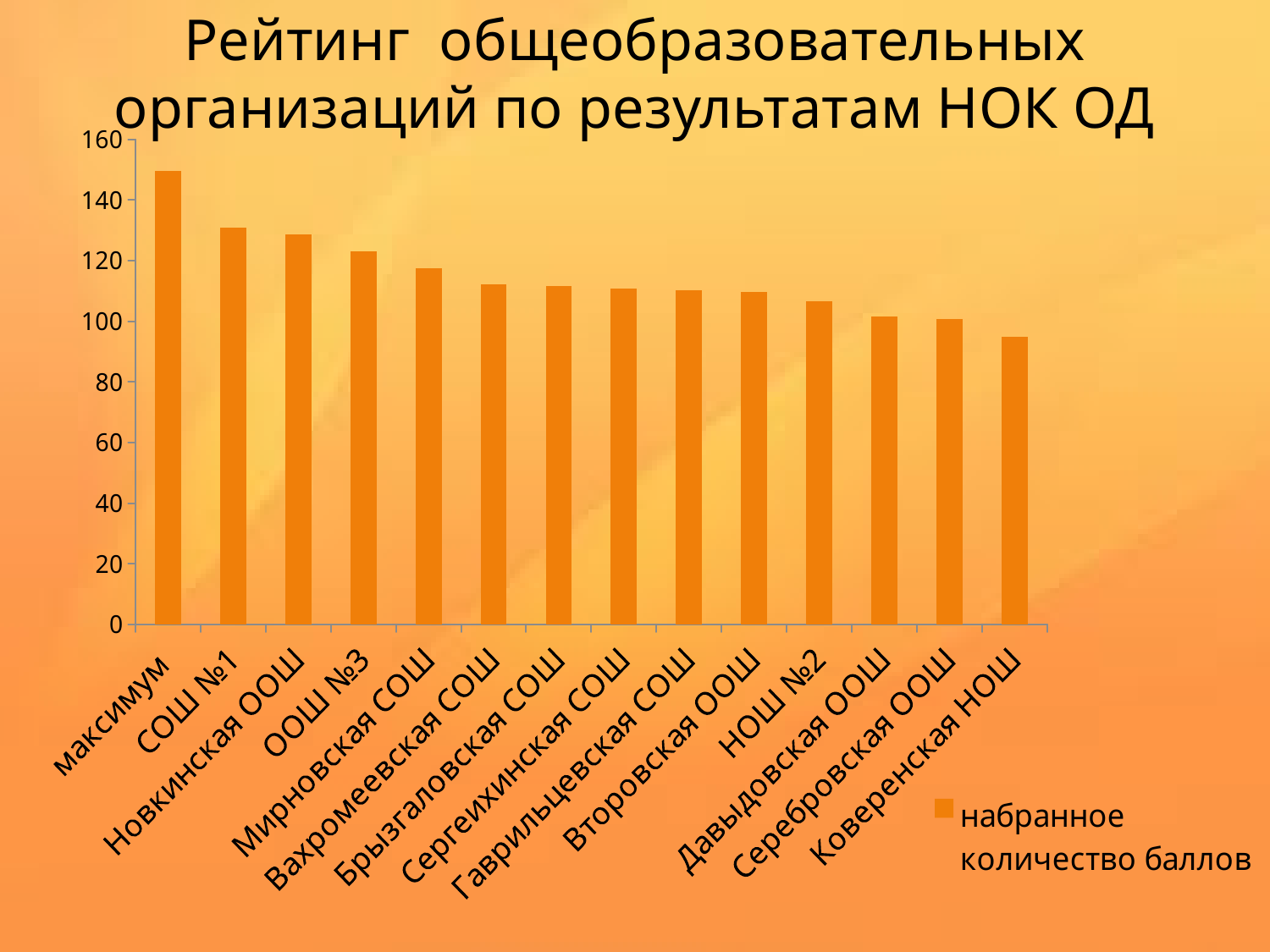
Which category has the highest bar? максимум Which category has the lowest bar? Коверенская НОШ What kind of chart is shown on the slide? bar chart How many categories are plotted along the x axis? 14 Which is larger, the value for СОШ №1 or the value for Ковёренская НОШ? СОШ №1 Is the value for максимум greater or less than 140? greater Is the value for Мирновская СОШ greater or less than 120? less Is the value for СОШ №1 greater or less than 120? greater Do the values rise or fall moving from left to right along the x axis? fall How many series does the legend list? 1